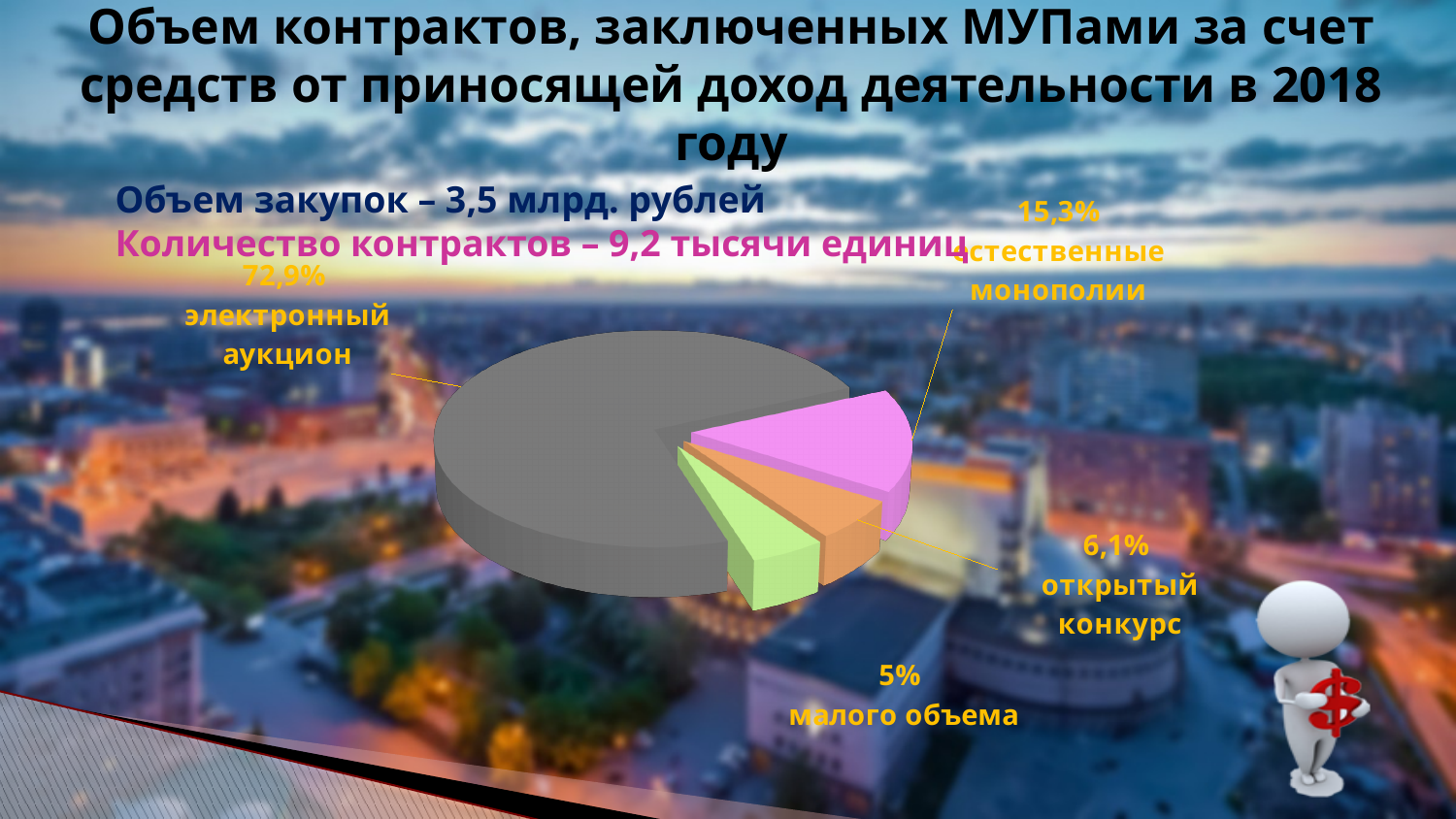
What is the value shown for "малого объема"? 5% Which is larger: the share for "открытый конкурс" or the share for "малого объема"? открытый конкурс What is the difference in percentage points between "естественные монополии" and "открытый конкурс"? 9,2 Which category has the largest slice of the pie? электронный аукцион What colour is the slice for "естественные монополии"? Pink What is the value shown for "открытый конкурс"? 6,1% How many slices does the pie chart have? 4 What share of the pie does "электронный аукцион" have? 72,9% What share of the pie does "естественные монополии" have? 15,3% Which category has the smallest slice of the pie? малого объема What type of chart is shown on the slide? Pie chart What is the difference in percentage points between "электронный аукцион" and "естественные монополии"? 57,6